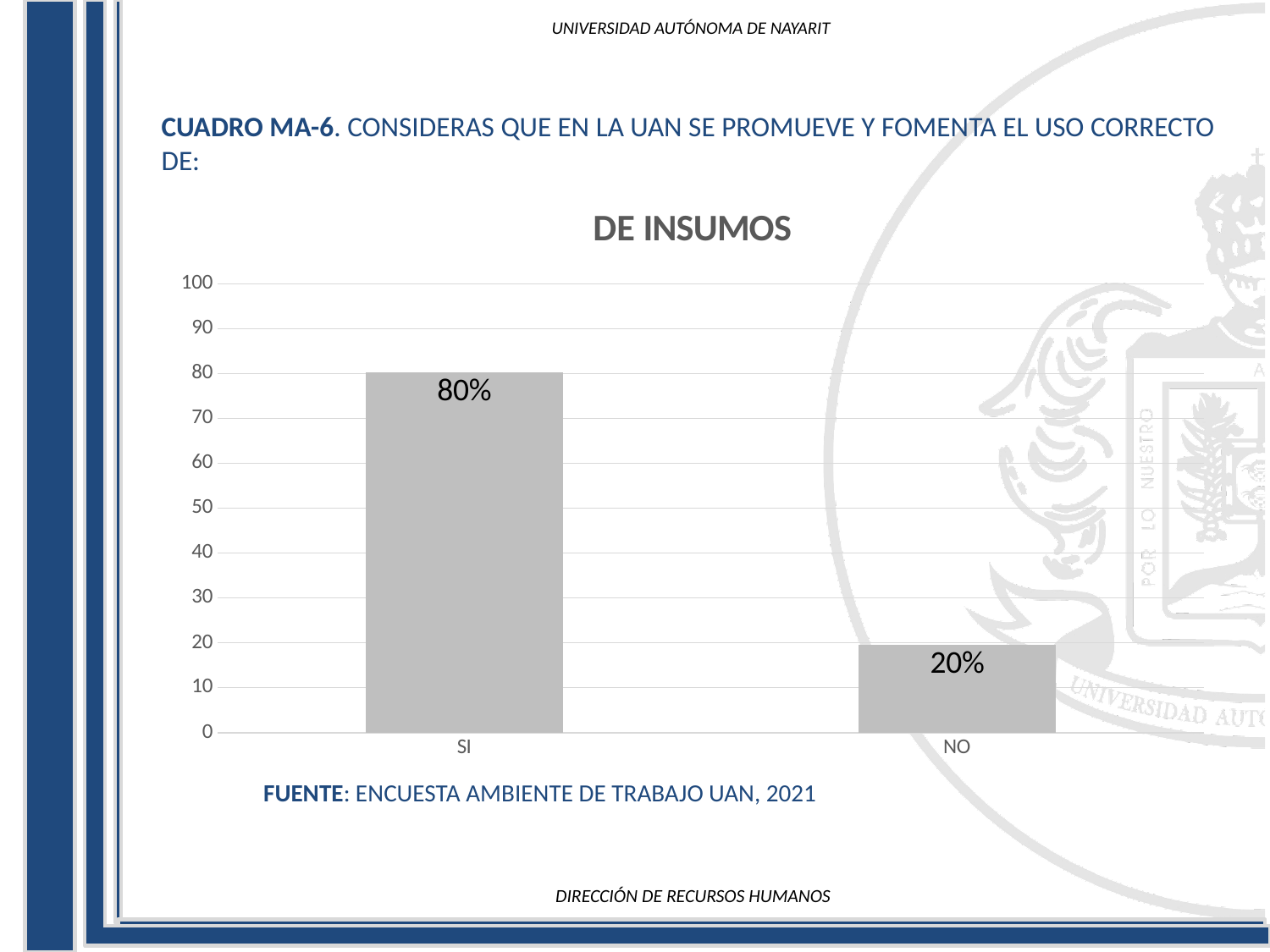
How many categories are shown on the x axis? 2 What is the difference between the values for SI and NO? 60% Is the value for NO greater or less than 30? less Which category has the highest value? SI What is the value for SI? 80% Which is larger, the value for SI or the value for NO? SI What is the maximum value shown on the y axis? 100 Is the value for SI greater or less than 50? greater What is the value for NO? 20% What kind of chart is shown on the slide? bar chart What is the title of the chart? DE INSUMOS Which category has the lowest value? NO